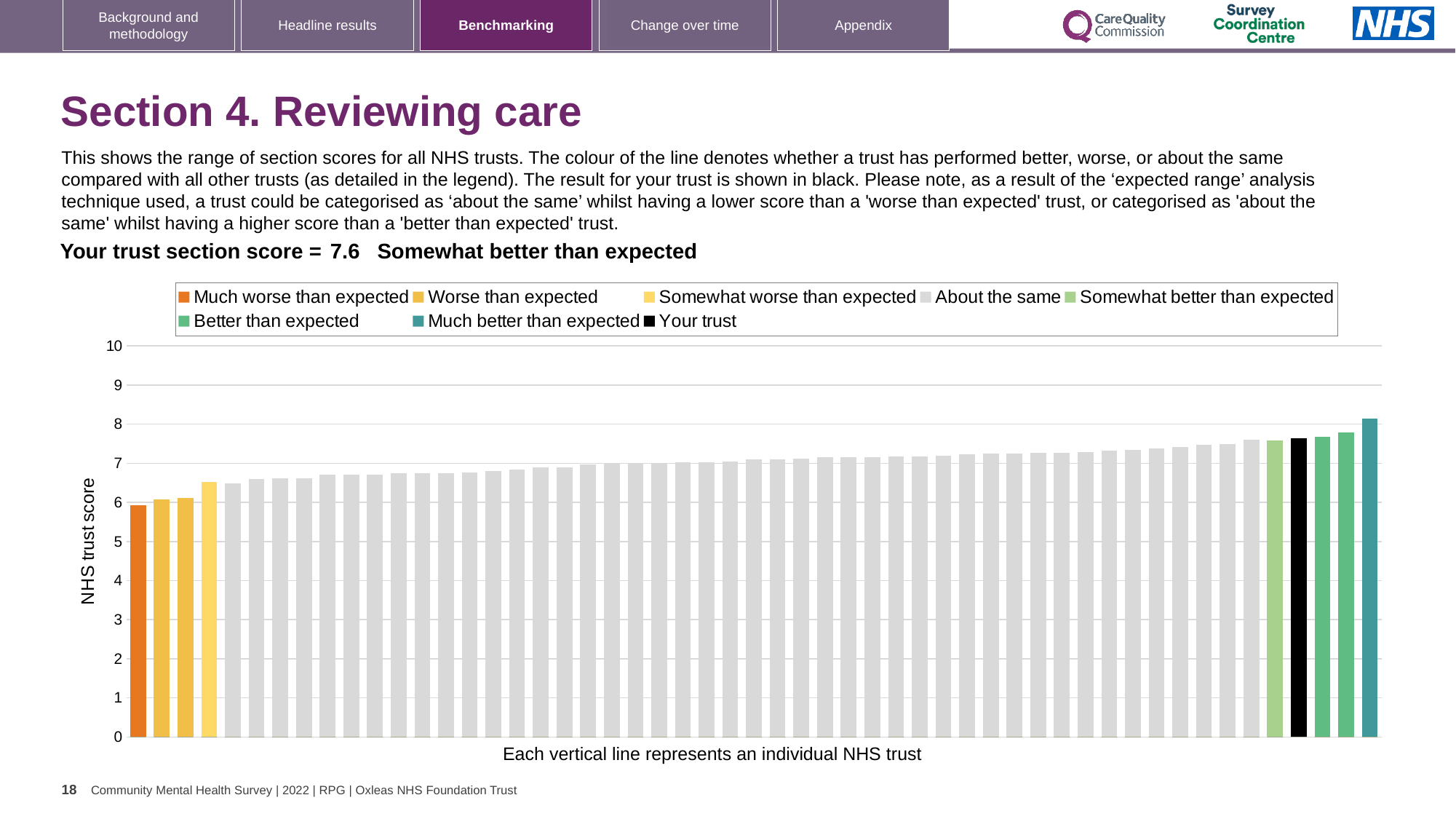
What is the section score for your trust shown on the slide? 7.6 How many bars are coloured as 'Better than expected'? 2 Which is larger: the score for your trust (black bar) or the score of the orange 'Much worse than expected' trust? your trust Is the value of the lowest bar (the orange 'Much worse than expected' trust) greater or less than 5? greater Is the value of the highest bar (the teal 'Much better than expected' trust) greater or less than 7? greater How many entries does the chart legend list? 8 Which category is your trust's section score placed in? Somewhat better than expected Do the bar values rise or fall from left to right along the x axis? rise Which is larger: the score for your trust (black bar) or the score of the teal 'Much better than expected' trust? the 'Much better than expected' trust What is the label on the vertical axis of the chart? NHS trust score How many bars are coloured as 'Much worse than expected'? 1 What kind of chart is shown on the slide? bar chart